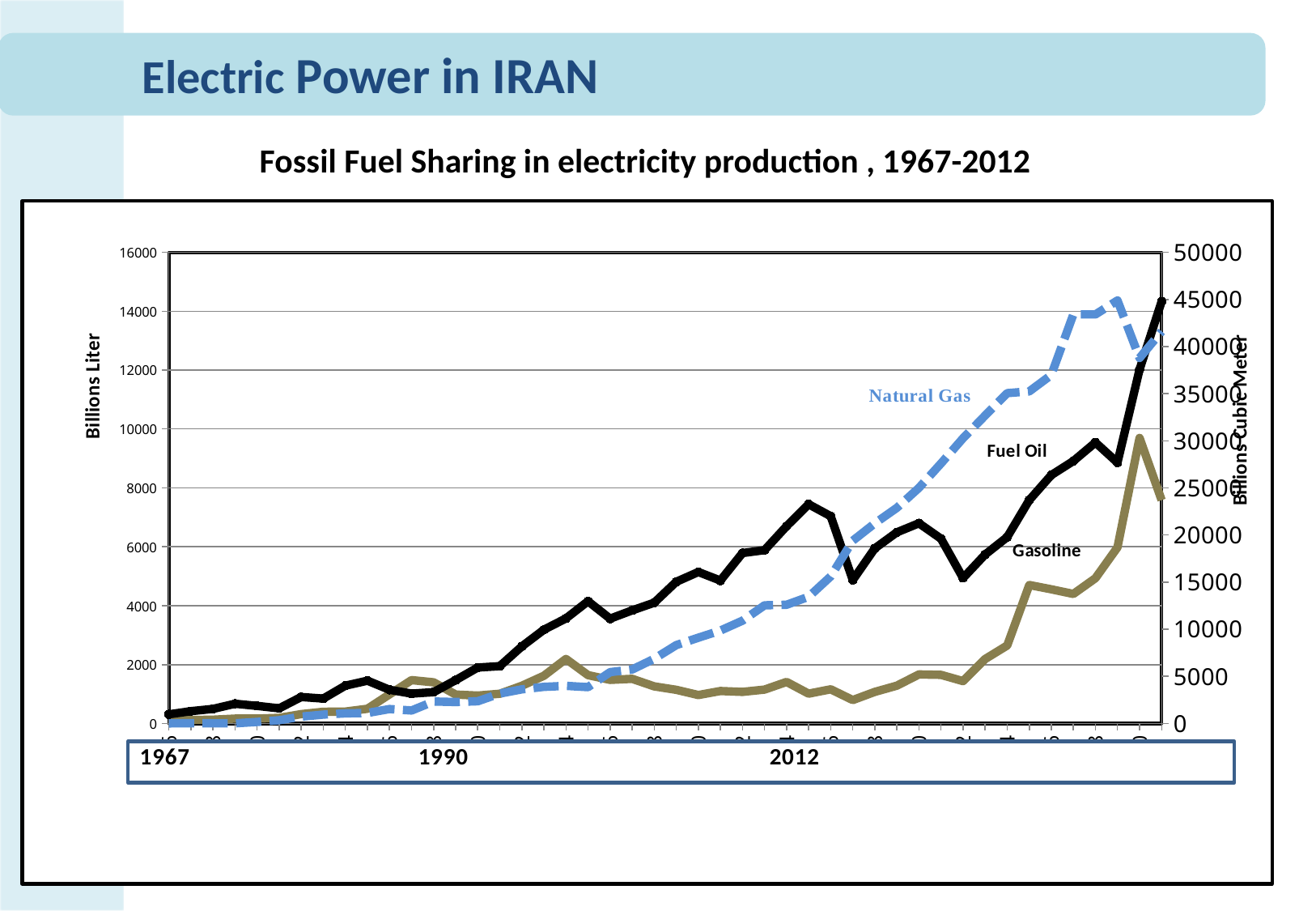
What is the title of the chart? Fossil Fuel Sharing in electricity production , 1967-2012 Overall, does the Fuel Oil series rise or fall from 1967 to 2012? rise At the end of the series (2012), which is higher on the left axis: Fuel Oil or Gasoline? Fuel Oil Is the Gasoline value at the end of the series (2012) greater or less than 6000 on the left axis? greater Is the peak of the Natural Gas series greater or less than 40000 on the right axis? greater What is the label of the left vertical axis? Billions Liter Is the Fuel Oil value at the end of the series (2012) greater or less than 12000 on the left axis? greater Overall, does the Natural Gas series rise or fall from 1967 to 2012? rise Which series reaches the highest value on the left axis (Billions Liter)? Fuel Oil What kind of chart is shown on the slide? line chart How many data series are labelled on the chart? 3